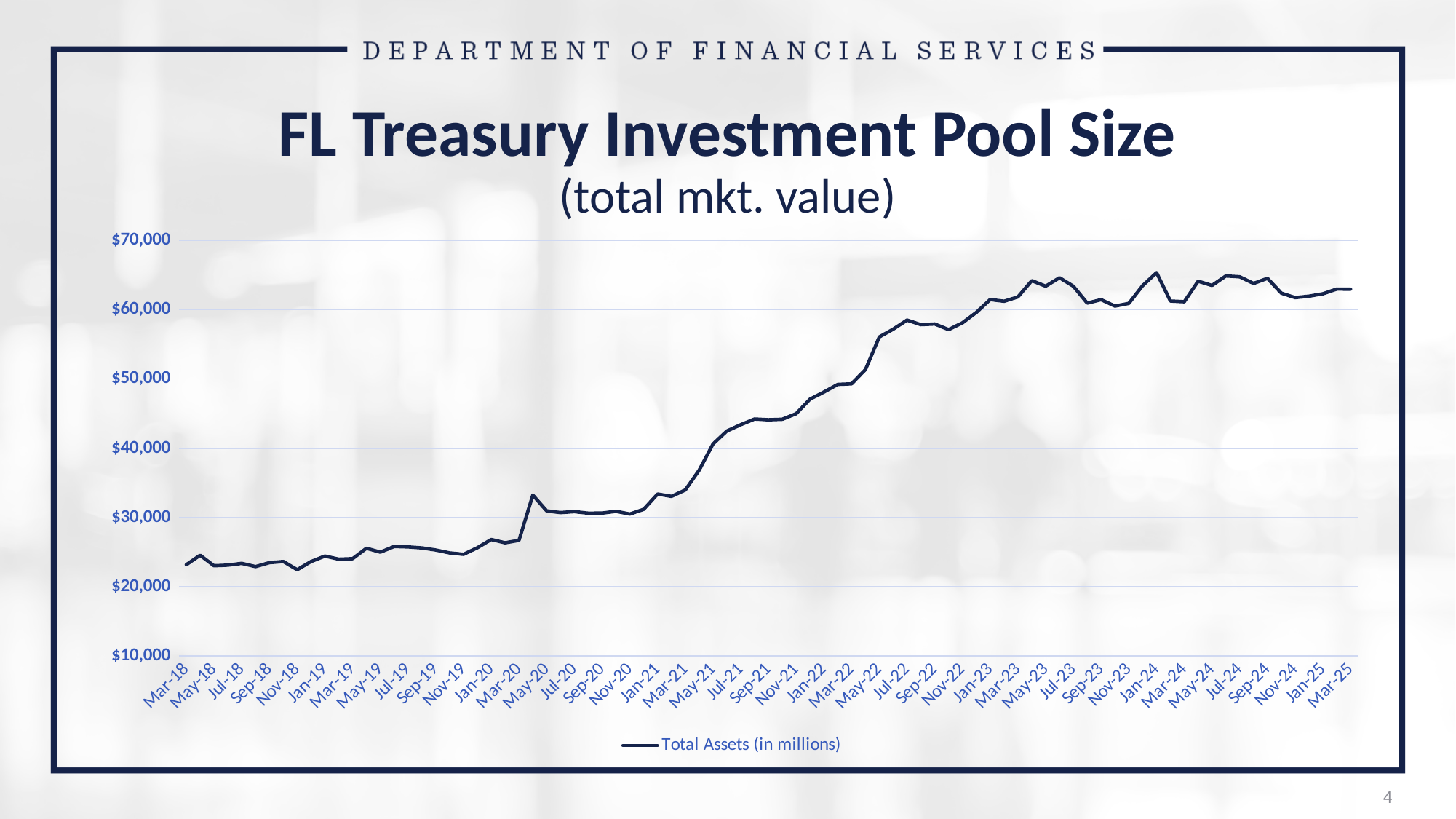
Is the value for Jan-22 greater or less than $50,000? less What is the name of the series shown in the legend? Total Assets (in millions) What is the title of the chart? FL Treasury Investment Pool Size (total mkt. value) Overall, do the values rise or fall from Mar-18 to Mar-25? rise Is the value for Mar-20 greater or less than $30,000? less Is the value for Jan-24 greater or less than $60,000? greater Which is larger, the value for Mar-18 or the value for Mar-25? Mar-25 What kind of chart is shown on the slide? line chart How many series does the legend list? 1